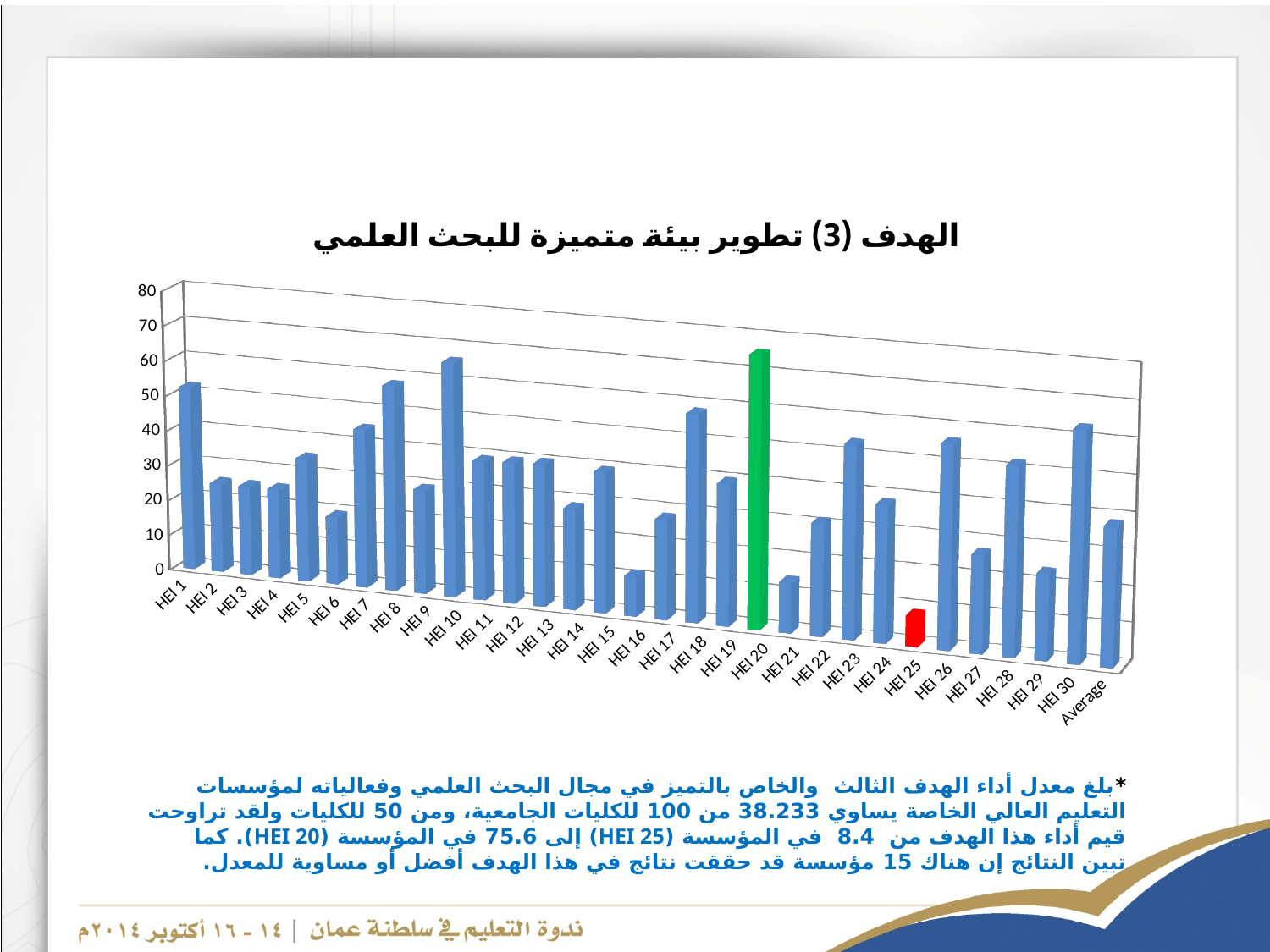
What kind of chart is shown on the slide? bar chart What colour is the bar for HEI 20? green Is the value for HEI 10 greater or less than 50? greater How many categories are plotted along the x axis of the chart? 31 Is the value for HEI 1 greater or less than 40? greater Which is larger, the value for HEI 18 or the value for HEI 19? HEI 18 Which category has the lowest value in the chart? HEI 25 What colour is the bar for HEI 25? red Which category has the highest value in the chart? HEI 20 Which is larger, the value for HEI 8 or the value for HEI 9? HEI 8